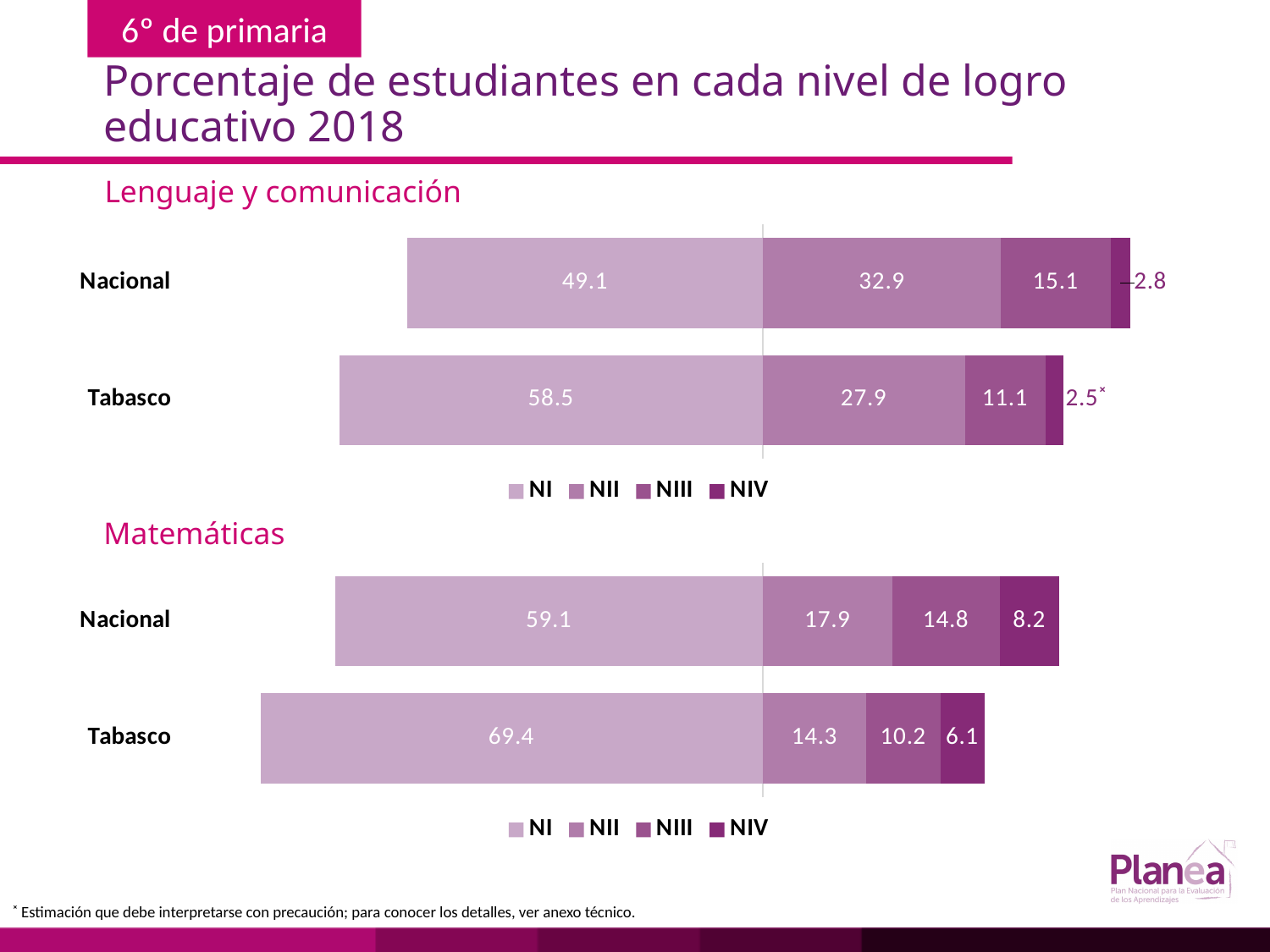
What type of chart is the Lenguaje y comunicación chart? Stacked bar chart In the Matemáticas chart, which has a larger NIII value, Nacional or Tabasco? Nacional In the Matemáticas chart, what is the total of the stacked bar for Tabasco? 100.0 In the Lenguaje y comunicación chart, what is the difference between the NI values for Tabasco and Nacional? 9.4 In the Lenguaje y comunicación chart, which level has the smallest share for Nacional? NIV In the Lenguaje y comunicación chart, what percentage of Nacional students are at level NI? 49.1 In the Matemáticas chart, what is the difference between the NII values for Nacional and Tabasco? 3.6 How many categories are shown in the Lenguaje y comunicación chart? 2 In the Matemáticas chart, what is the NIV value for Nacional? 8.2 In the Lenguaje y comunicación chart, what is the NIII value for Tabasco? 11.1 In the Matemáticas chart, what is the NI value for Tabasco? 69.4 How many series does the legend of the Matemáticas chart list? 4